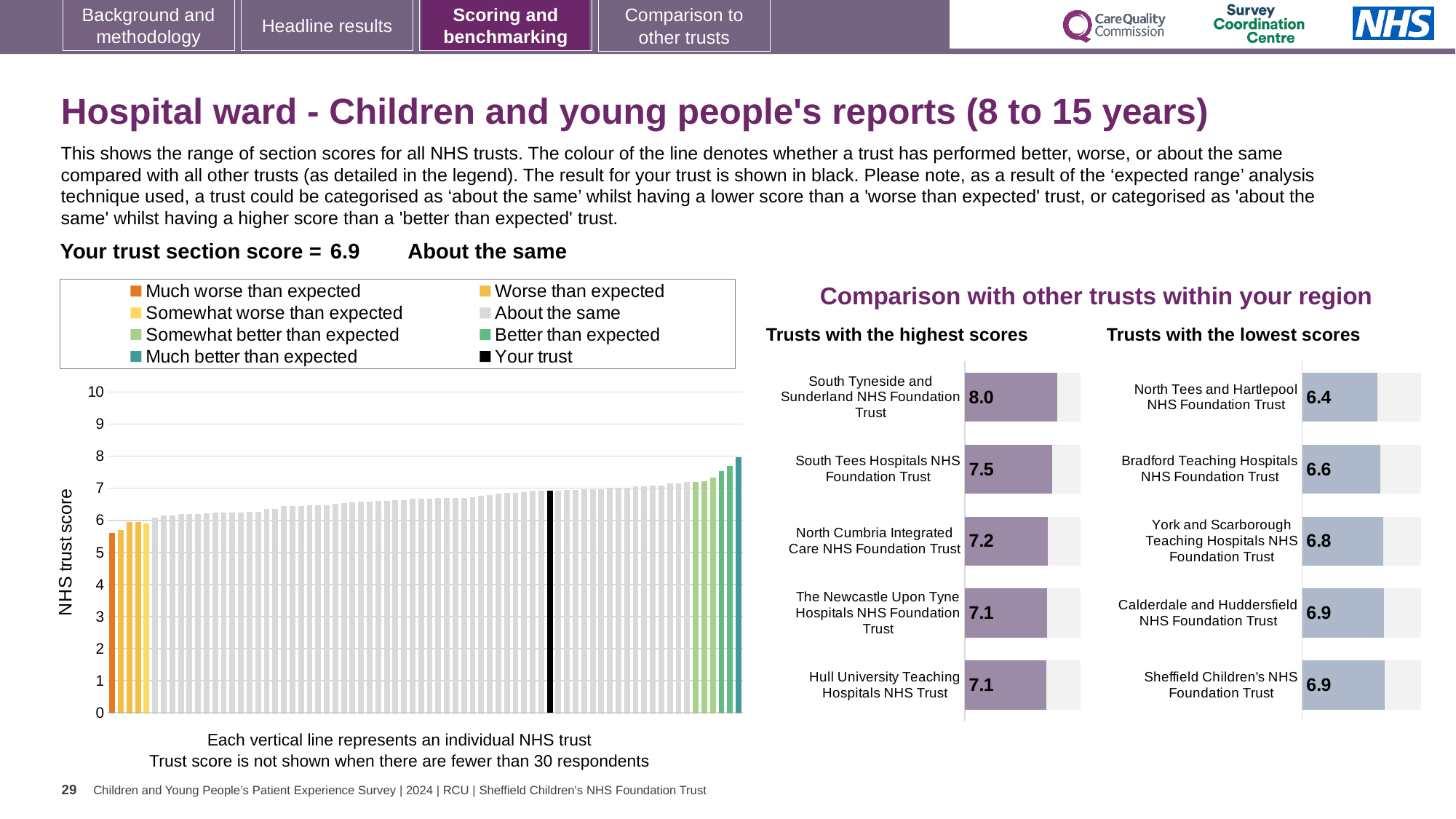
What kind of chart is the large 'NHS trust score' chart on the left? bar chart In the 'Trusts with the lowest scores' chart, which trust has the lowest score? North Tees and Hartlepool NHS Foundation Trust In the 'Trusts with the lowest scores' chart, which has the higher score: York and Scarborough Teaching Hospitals NHS Foundation Trust or Bradford Teaching Hospitals NHS Foundation Trust? York and Scarborough Teaching Hospitals NHS Foundation Trust How many trusts are shown in the 'Trusts with the lowest scores' chart? 5 In the large 'NHS trust score' chart on the left, do the bar values rise or fall from left to right? rise In the 'Trusts with the highest scores' chart, what is the difference between the scores of South Tyneside and Sunderland NHS Foundation Trust and South Tees Hospitals NHS Foundation Trust? 0.5 In the 'Trusts with the lowest scores' chart, what is the difference between the scores of Sheffield Children's NHS Foundation Trust and North Tees and Hartlepool NHS Foundation Trust? 0.5 In the 'Trusts with the highest scores' chart, which trust has the highest score? South Tyneside and Sunderland NHS Foundation Trust In the 'Trusts with the lowest scores' chart, what is the score for Bradford Teaching Hospitals NHS Foundation Trust? 6.6 In the 'Trusts with the highest scores' chart, what is the score for South Tyneside and Sunderland NHS Foundation Trust? 8.0 How many entries does the legend of the large 'NHS trust score' chart on the left list? 8 In the 'Trusts with the highest scores' chart, what is the score for North Cumbria Integrated Care NHS Foundation Trust? 7.2